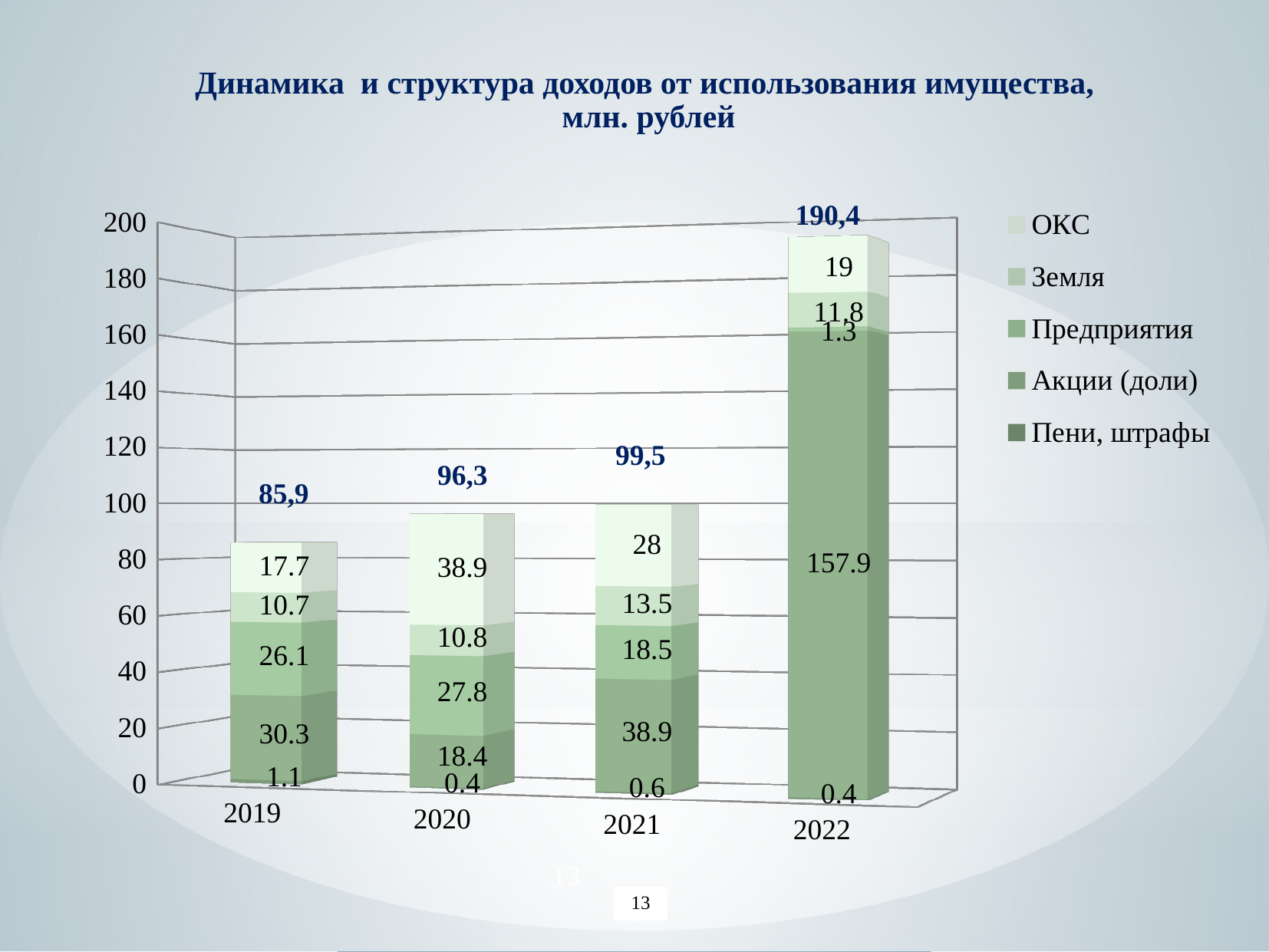
What is the value of ОКС in 2020? 38.9 How many years (categories) are shown on the x axis? 4 What type of chart is shown on the slide? stacked bar chart How many series does the legend list? 5 Which year has the lowest total income? 2019 What is the difference between the total for 2022 and the total for 2021? 90,9 What is the total value printed above the bar for 2022? 190,4 What is the value of Земля in 2021? 13.5 What is the value of Акции (доли) in 2022? 157.9 Do the total values rise or fall from 2019 to 2022? rise Which is larger: Предприятия in 2019 or Предприятия in 2020? Предприятия in 2020 Which year has the highest total income? 2022